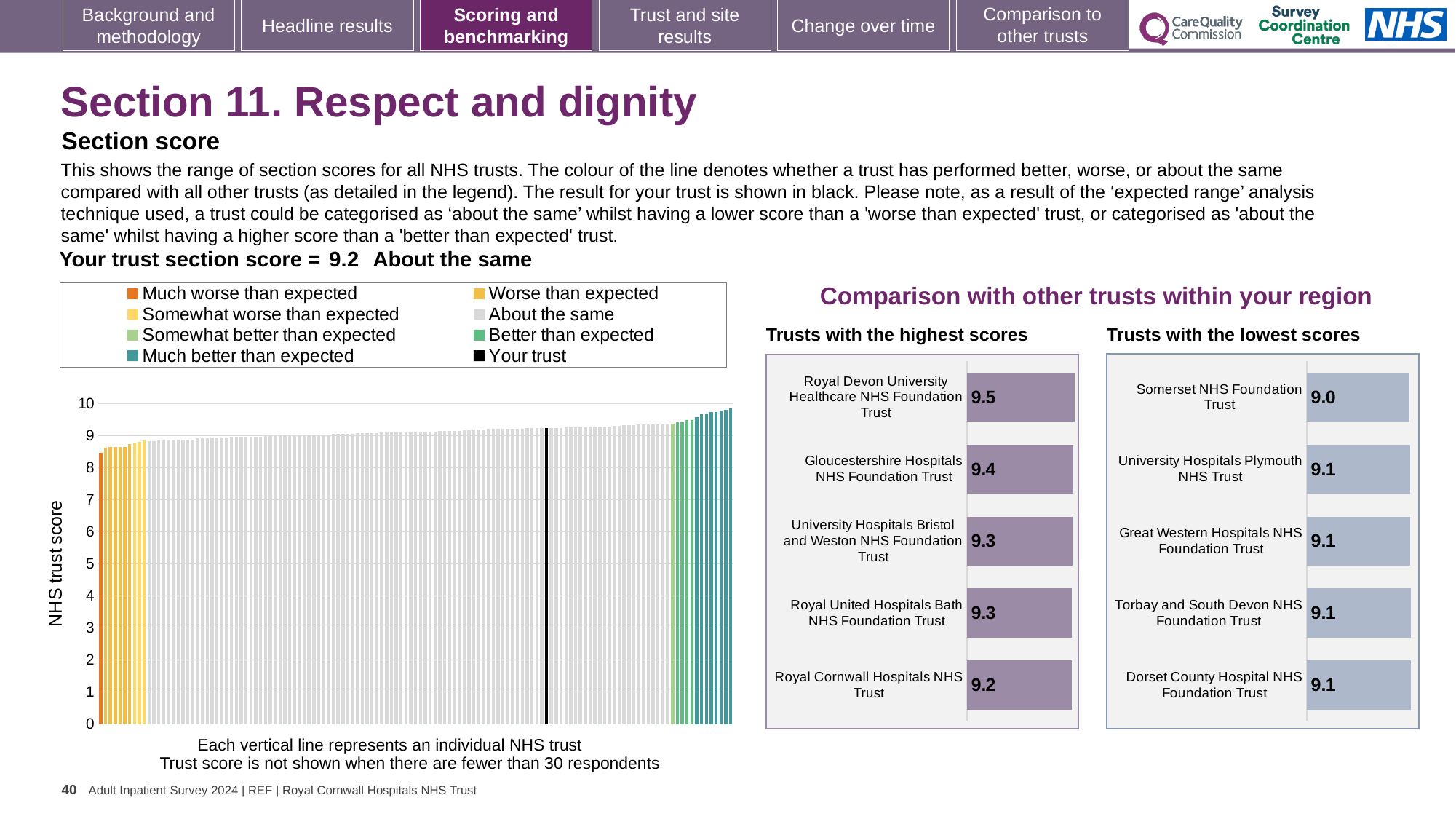
In the 'Trusts with the highest scores' chart, what is the score for Royal Devon University Healthcare NHS Foundation Trust? 9.5 In the large 'NHS trust score' chart on the left, do the values rise or fall from left to right along the x axis? Rise In the 'Trusts with the lowest scores' chart, what is the score for Somerset NHS Foundation Trust? 9.0 How many entries does the legend of the large 'NHS trust score' chart list? 8 In the large 'NHS trust score' chart on the left, is the value of the leftmost (lowest) bar greater or less than 9? less In the 'Trusts with the highest scores' chart, which trust has the highest score? Royal Devon University Healthcare NHS Foundation Trust What type of chart is the large 'NHS trust score' chart on the left? Bar chart In the 'Trusts with the highest scores' chart, what is the difference between the scores of Royal Devon University Healthcare NHS Foundation Trust and Royal Cornwall Hospitals NHS Trust? 0.3 In the 'Trusts with the highest scores' chart, what is the score for Gloucestershire Hospitals NHS Foundation Trust? 9.4 How many trusts are listed in the 'Trusts with the highest scores' chart? 5 In the 'Trusts with the lowest scores' chart, which trust has the lowest score? Somerset NHS Foundation Trust Which is larger: the score for Royal Devon University Healthcare NHS Foundation Trust in the highest scores chart, or the score for Somerset NHS Foundation Trust in the lowest scores chart? Royal Devon University Healthcare NHS Foundation Trust